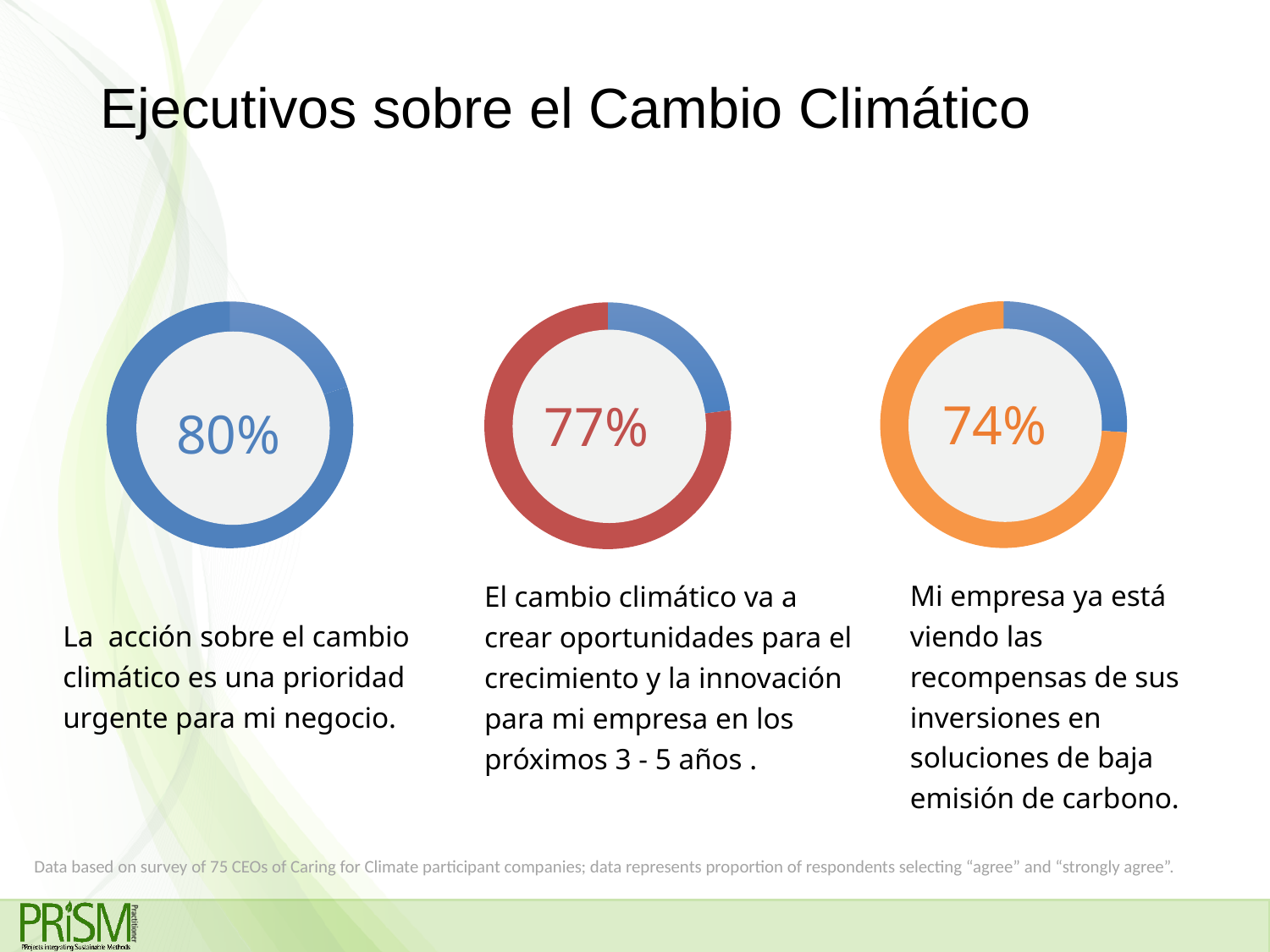
What percentage is shown in the middle doughnut chart (El cambio climático va a crear oportunidades para el crecimiento y la innovación)? 77% Which of the three doughnut charts shows the highest percentage? The left chart, 80% What is the difference in percentage points between the left chart (80%) and the right chart (74%)? 6 percentage points What percentage is shown in the right doughnut chart (Mi empresa ya está viendo las recompensas de sus inversiones)? 74% What is the difference in percentage points between the left chart (80%) and the middle chart (77%)? 3 percentage points Which is larger, the percentage in the middle doughnut chart or the percentage in the right doughnut chart? The middle chart (77%) How many doughnut charts are shown on the slide? 3 What share of the middle doughnut chart is not covered by the 77% segment? 23% What type of chart is used to display the percentages on this slide? Doughnut chart What percentage is shown in the left doughnut chart (La acción sobre el cambio climático es una prioridad urgente para mi negocio)? 80% Which of the three doughnut charts shows the lowest percentage? The right chart, 74% What colour is the main (77%) segment of the middle doughnut chart? Red